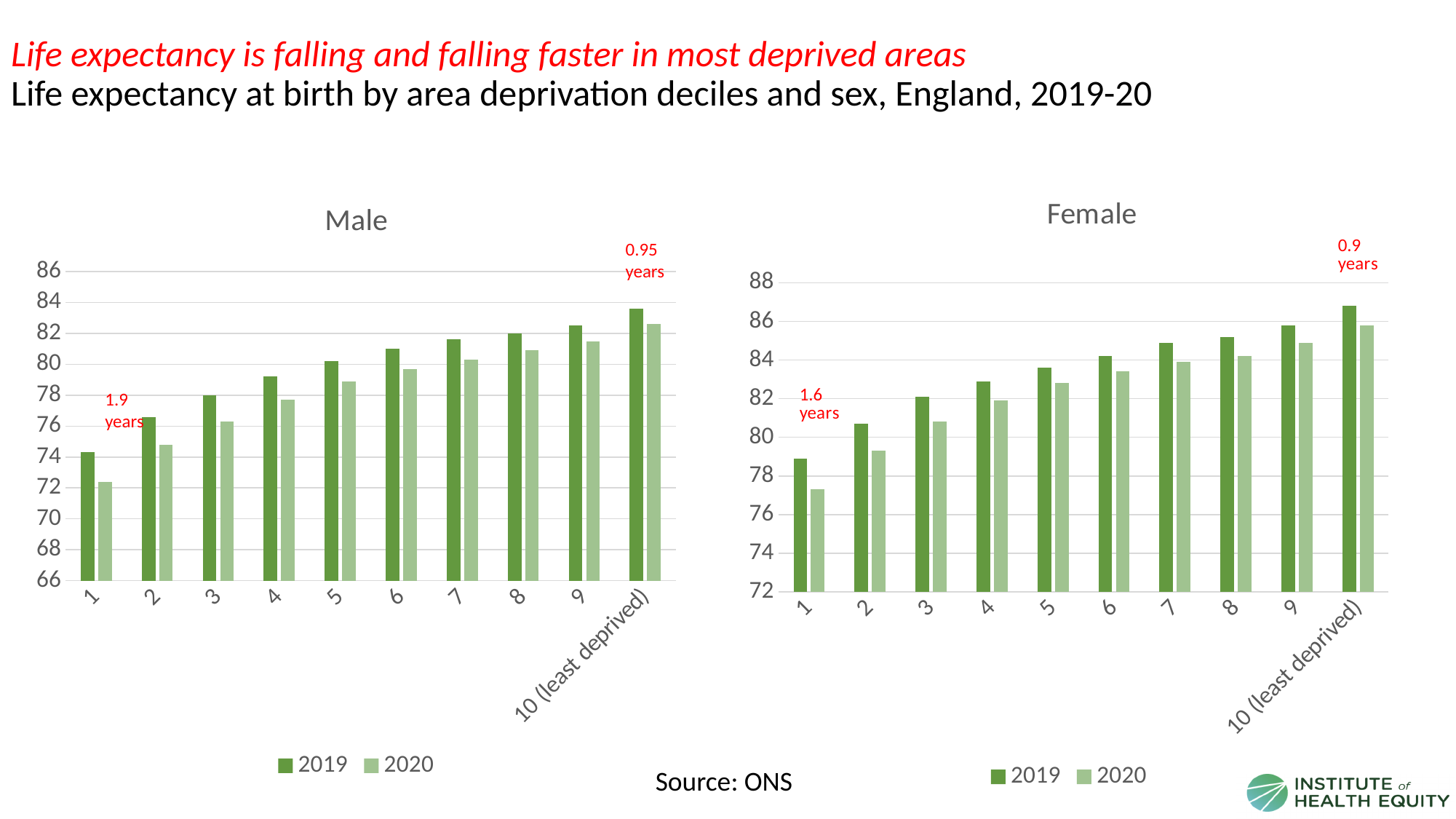
In the Female chart, what fall in life expectancy is annotated for decile 10 (least deprived)? 0.9 years In the Female chart, is the 2020 value for decile 1 greater or less than 78? less In the Male chart, is the 2020 value for decile 1 greater or less than 74? less How many deprivation deciles are shown on the x axis of the Female chart? 10 In the Female chart, is the 2019 value for decile 10 (least deprived) greater or less than 86? greater In the Male chart, what fall in life expectancy is annotated for decile 1? 1.9 years How many series does the legend of the Male chart list? 2 In the Male chart, which decile has the lowest 2020 life expectancy? 1 In the Male chart, for decile 5, which is larger: the 2019 value or the 2020 value? 2019 In the Female chart, which decile has the highest 2019 life expectancy? 10 (least deprived) In the Male chart, do the 2019 values rise or fall from decile 1 to decile 10 (least deprived)? rise What kind of chart is the Male chart? bar chart